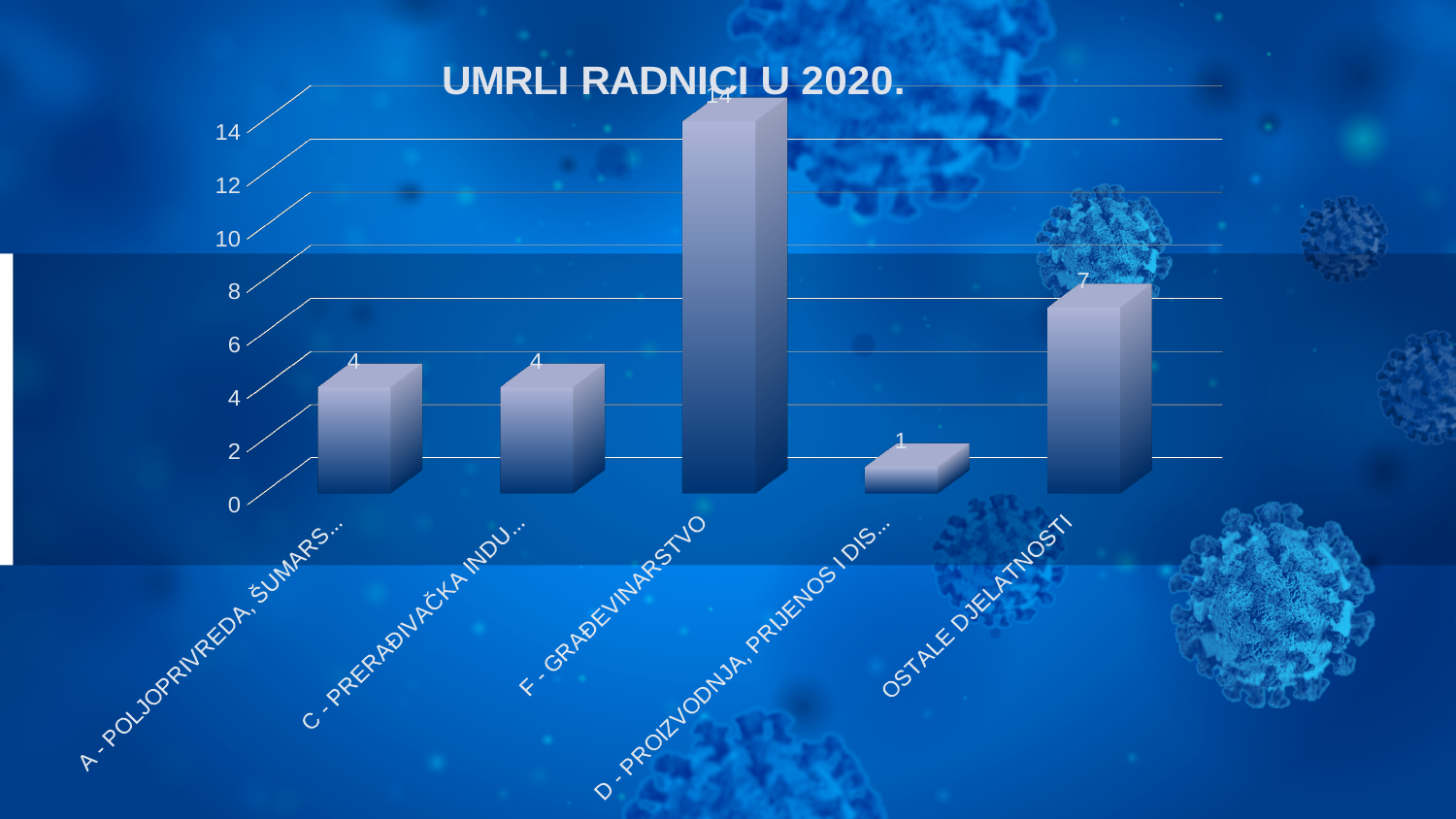
Which category has the highest value? F - GRAĐEVINARSTVO Is the value for F - GRAĐEVINARSTVO greater or less than 10? greater What kind of chart is shown on the slide? bar chart Which category has the lowest value? D - PROIZVODNJA, PRIJENOS I DIS... What is the value for the category labelled A - POLJOPRIVREDA, ŠUMARS...? 4 What is the difference between the values for F - GRAĐEVINARSTVO and OSTALE DJELATNOSTI? 7 What is the value for F - GRAĐEVINARSTVO? 14 What is the title of the chart? UMRLI RADNICI U 2020. What is the value for OSTALE DJELATNOSTI? 7 How many categories are shown in the chart? 5 Which is larger, the value for OSTALE DJELATNOSTI or the value for C - PRERAĐIVAČKA INDU...? OSTALE DJELATNOSTI What is the value for the category labelled D - PROIZVODNJA, PRIJENOS I DIS...? 1